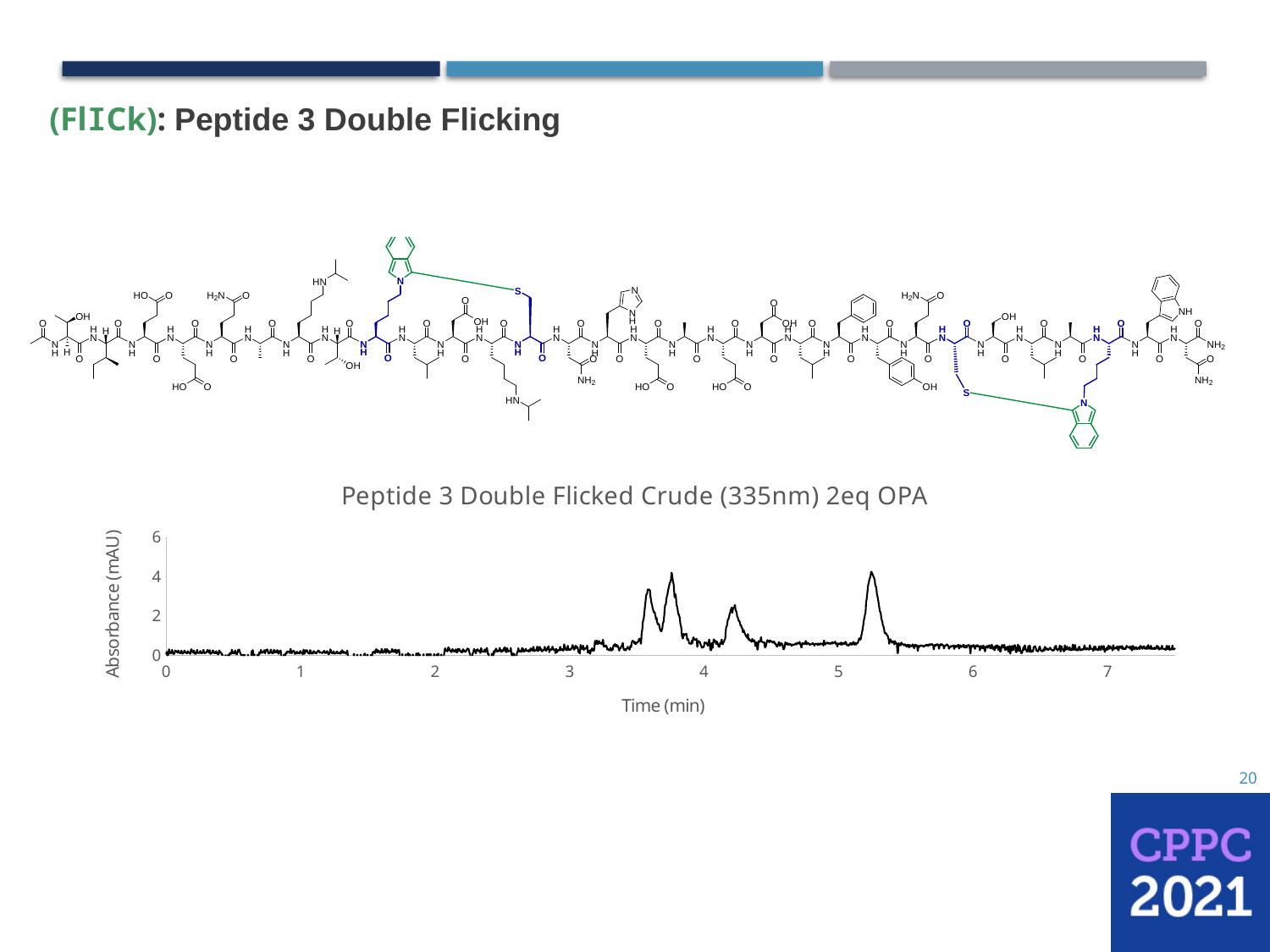
What is the highest value shown on the y axis of the chart? 6 Is the absorbance at 6 min greater or less than 2 mAU? less Which is larger, the absorbance at 2 min or the absorbance of the peak near 5.2 min? the peak near 5.2 min Is the absorbance of the peak near 4.2 min greater or less than 4 mAU? less Is the absorbance of the peak near 5.2 min greater or less than 6 mAU? less What is the title of the chart? Peptide 3 Double Flicked Crude (335nm) 2eq OPA What is the label of the x axis of the chart? Time (min) What kind of chart is shown on the slide? line chart Which is larger, the absorbance of the peak near 3.8 min or the peak near 4.2 min? the peak near 3.8 min